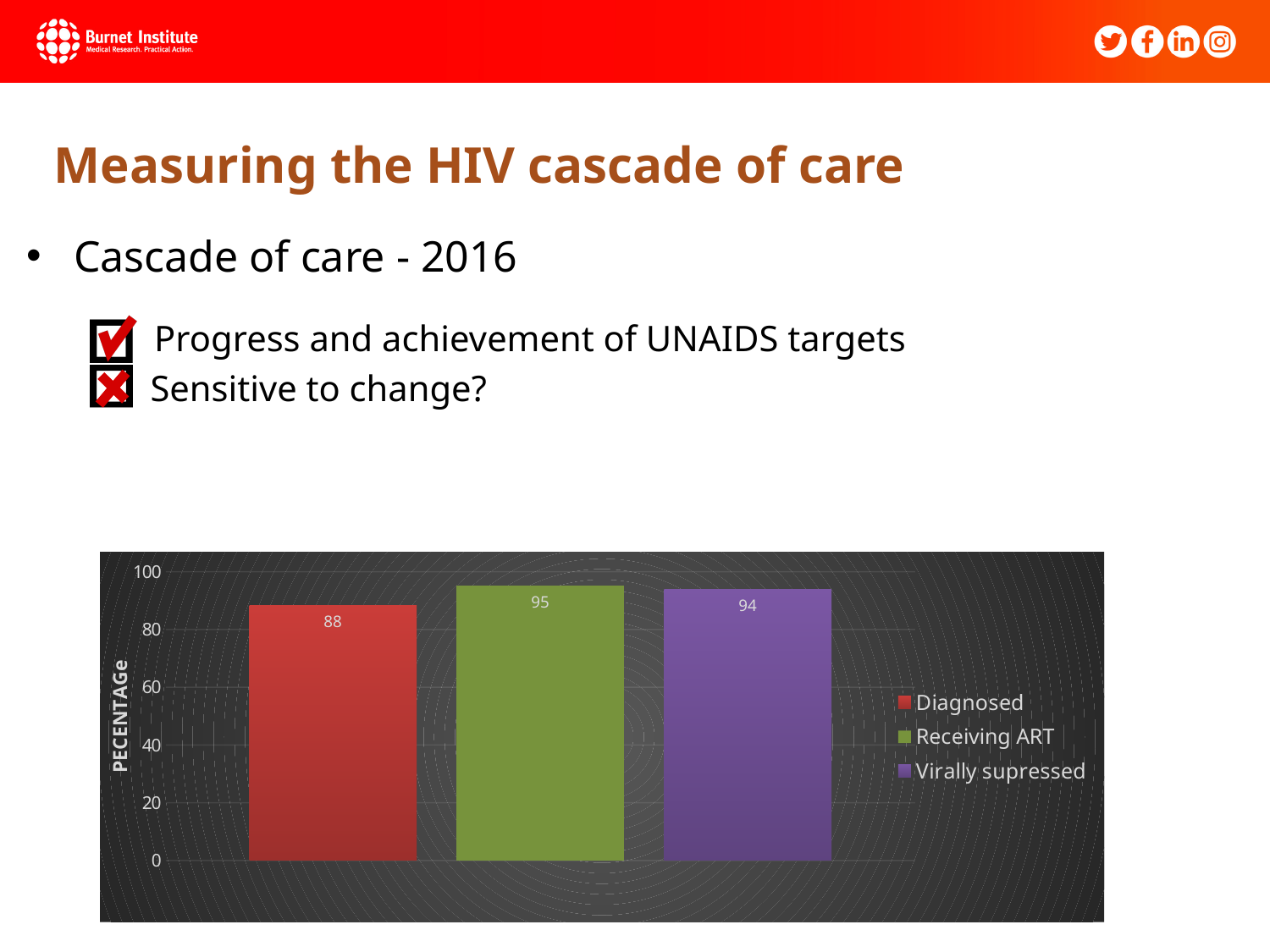
Is the value for Diagnosed greater or less than 80? greater What is the difference between the values for Receiving ART and Diagnosed? 7 What is the value for Diagnosed? 88 What is the value for Receiving ART? 95 Which series has the lowest value? Diagnosed What is the difference between the values for Virally supressed and Diagnosed? 6 What is the label on the vertical axis of the chart? PECENTAGe Which series has the highest value? Receiving ART What kind of chart is shown on the slide? Bar chart What is the value for Virally supressed? 94 How many series does the legend list? 3 Which is larger, the value for Diagnosed or the value for Virally supressed? Virally supressed